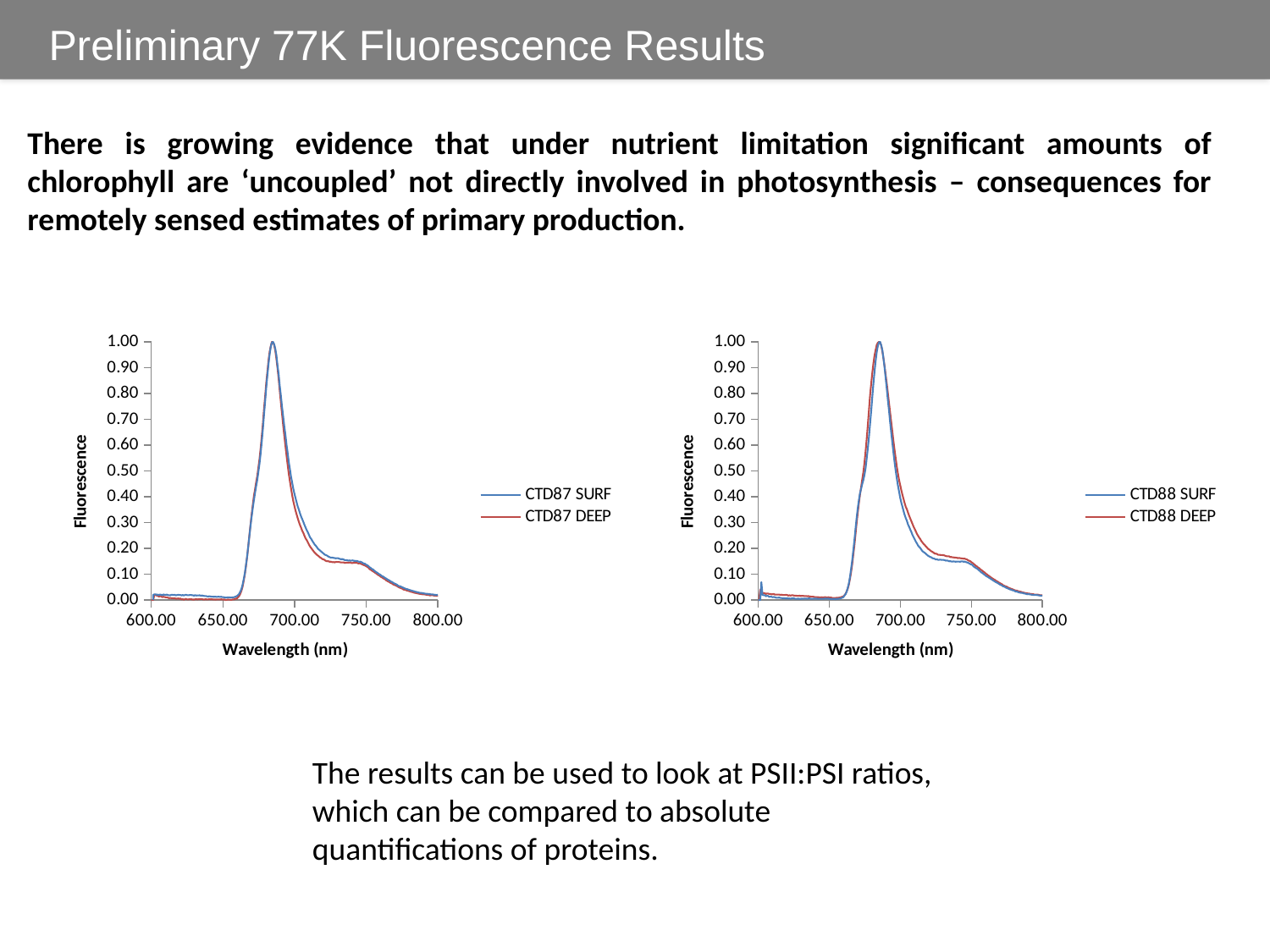
What kind of chart is the right chart (CTD88)? line chart In the left chart (CTD87), do the fluorescence values of CTD87 SURF rise or fall between 700.00 nm and 800.00 nm? fall In the left chart (CTD87), is the peak fluorescence value of CTD87 SURF greater or less than 0.90? greater In the left chart (CTD87), what are the two series named in the legend? CTD87 SURF and CTD87 DEEP How many series does the legend of the right chart (CTD88) list? 2 In the left chart (CTD87), is the fluorescence of CTD87 DEEP at 650.00 nm greater or less than 0.10? less What kind of chart is the left chart (CTD87)? line chart In the right chart (CTD88), do the fluorescence values of CTD88 DEEP rise or fall between 650.00 nm and 685 nm (the peak)? rise In the right chart (CTD88), is the fluorescence of CTD88 DEEP at 750.00 nm greater or less than 0.30? less In the right chart (CTD88), what is the label of the y axis? Fluorescence How many series does the legend of the left chart (CTD87) list? 2